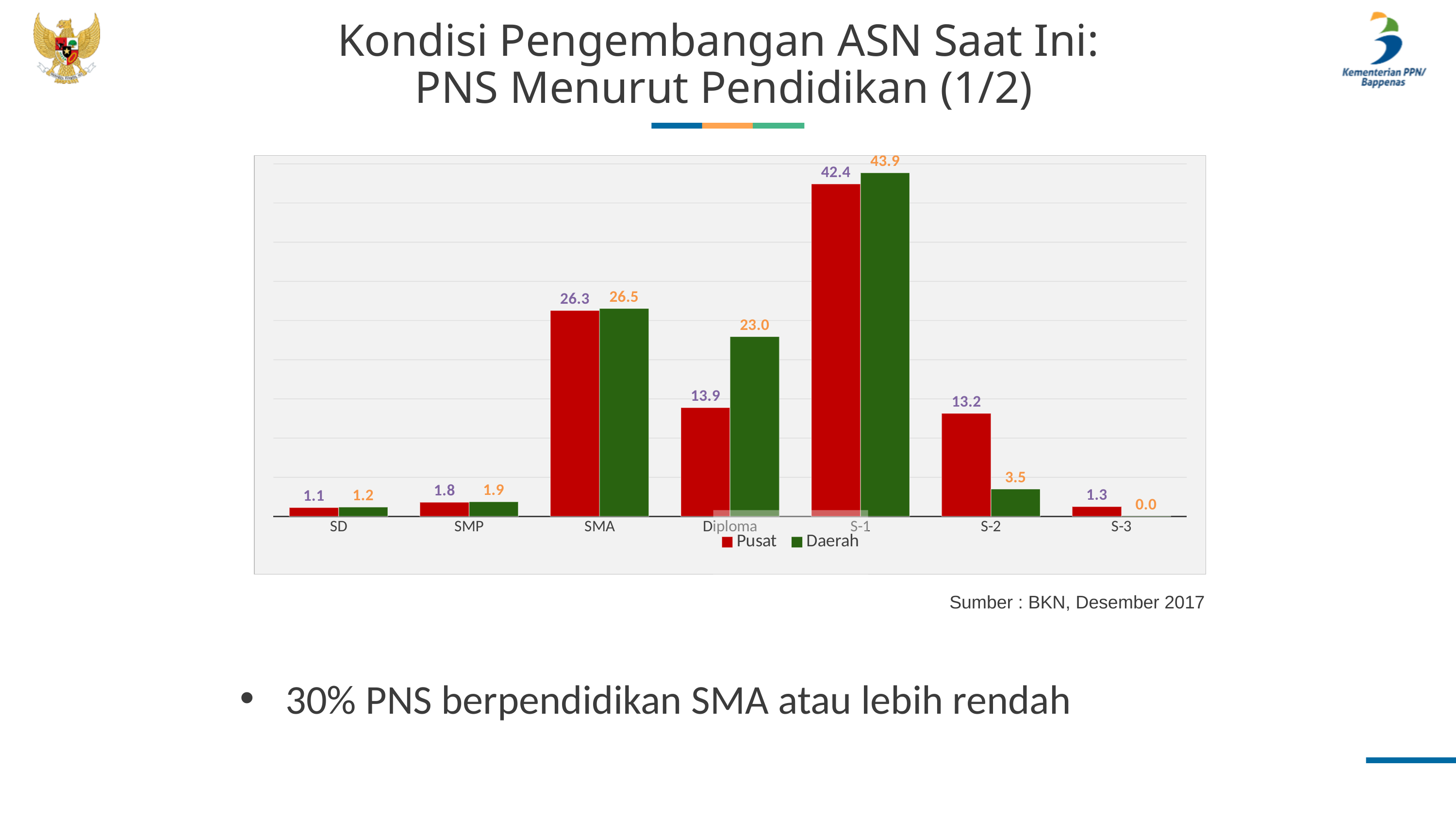
What is the Pusat value for S-1? 42.4 Which education category has the highest Daerah value? S-1 What is the difference between the Daerah and Pusat values for Diploma? 9.1 What kind of chart is shown on the slide? Bar chart Which colour represents the Daerah series? Green Which is larger for S-2, the Pusat value or the Daerah value? Pusat Which education category has the lowest Pusat value? SD What is the Daerah value for S-3? 0.0 How many series does the legend list? 2 What is the difference between the Pusat and Daerah values for S-2? 9.7 How many education categories are shown on the x axis? 7 What is the Daerah value for Diploma? 23.0